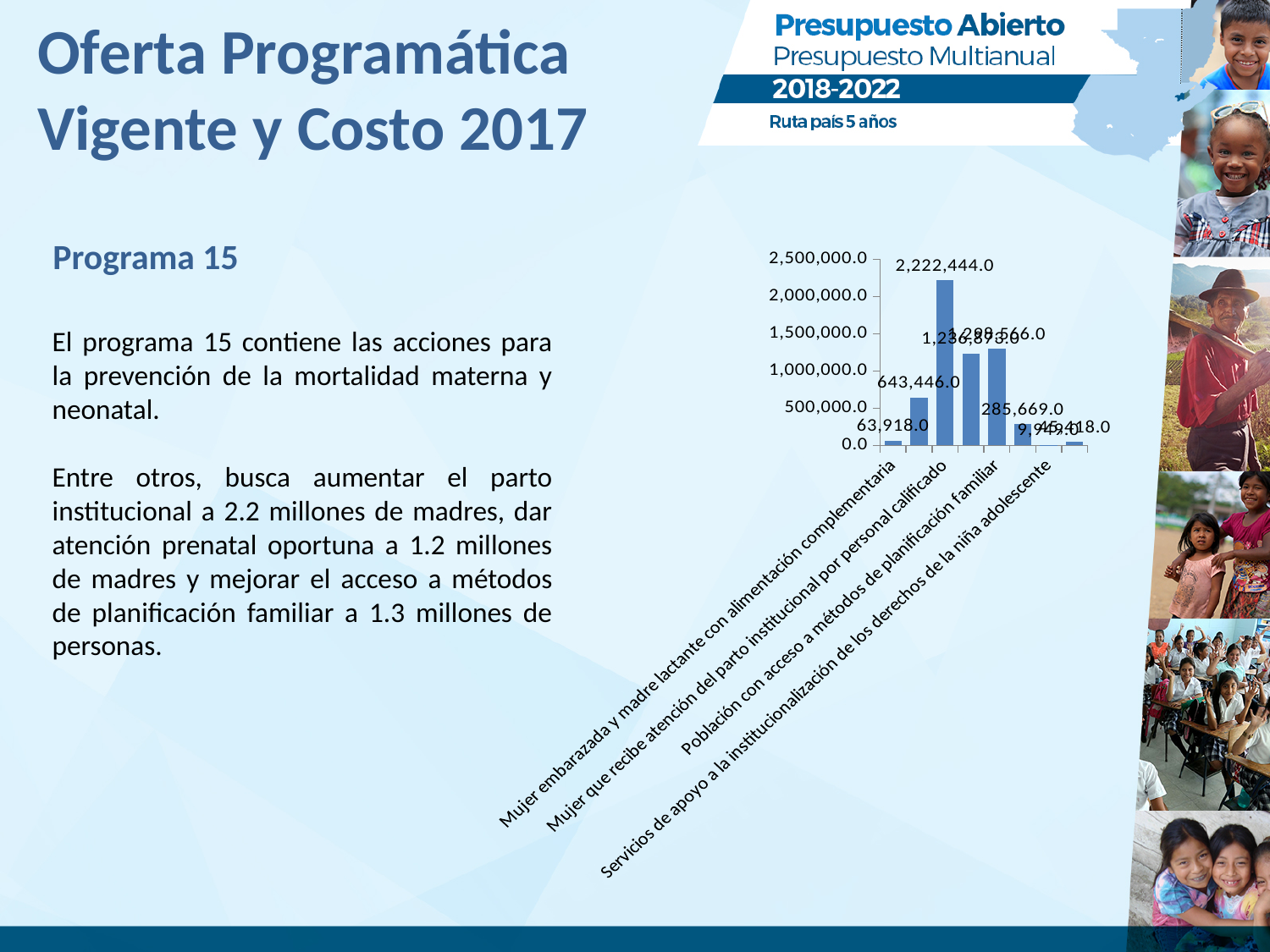
What is the difference between the highest bar (2,222,444.0) and the second bar (643,446.0)? 1,578,998.0 What kind of chart is shown on the slide? bar chart What is the value of the sixth bar in the chart? 285,669.0 Which category has the highest value in the chart? Mujer que recibe atención del parto institucional por personal calificado What is the value for 'Mujer que recibe atención del parto institucional por personal calificado'? 2,222,444.0 Which is larger, the second bar (643,446.0) or the sixth bar (285,669.0)? 643,446.0 What is the top value shown on the vertical axis of the chart? 2,500,000.0 What is the highest value shown in the chart? 2,222,444.0 How many bars are plotted in the chart? 8 What is the value of the second bar in the chart? 643,446.0 What is the value for 'Mujer embarazada y madre lactante con alimentación complementaria'? 63,918.0 Is the value of the second bar greater or less than 1,000,000.0? less